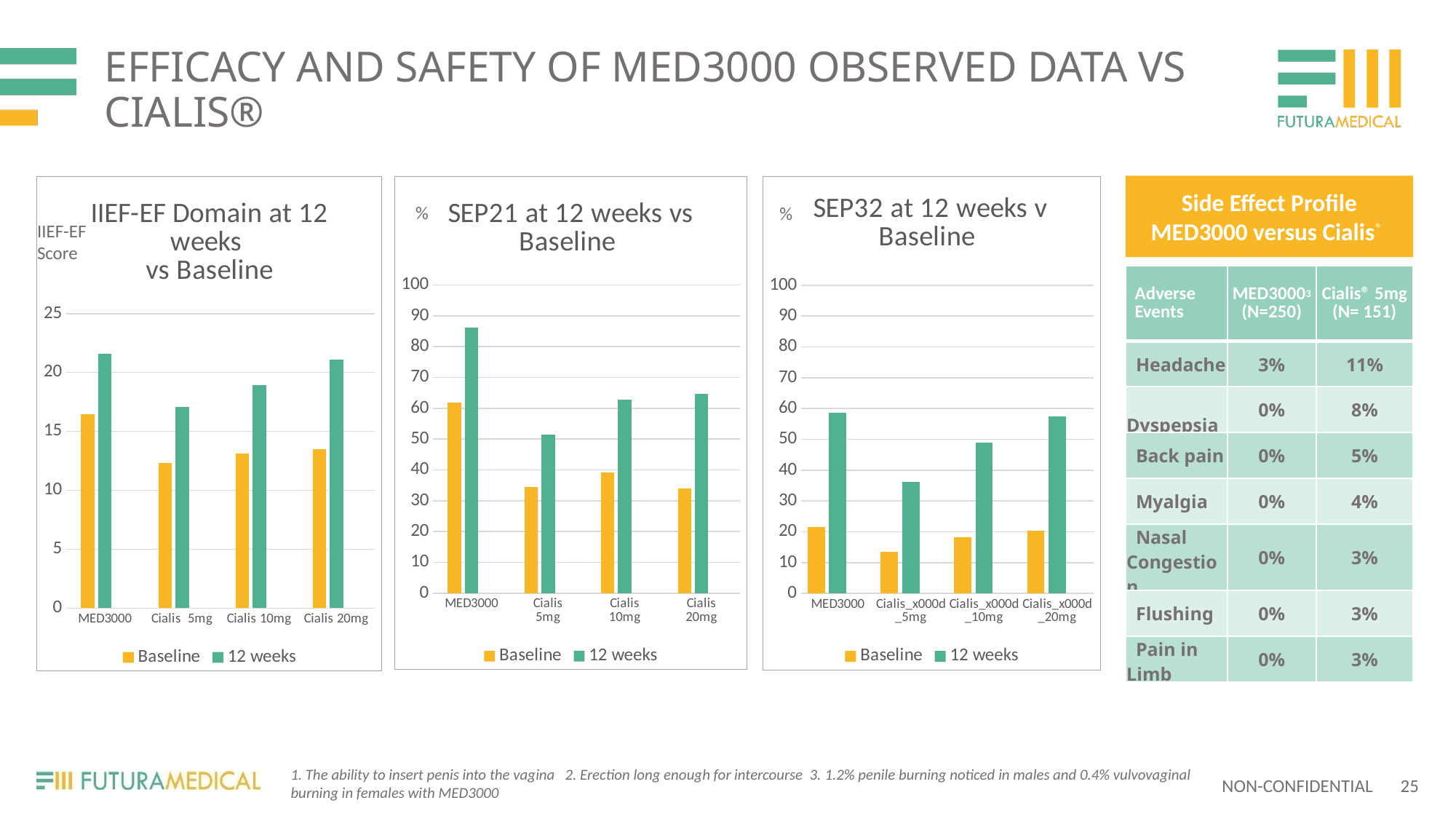
In the SEP32 at 12 weeks v Baseline chart, which category has the lowest Baseline value? Cialis 5mg In the SEP21 at 12 weeks vs Baseline chart, which category has the highest 12 weeks value? MED3000 In the SEP32 at 12 weeks v Baseline chart, is the 12 weeks value for Cialis 5mg greater or less than 40? less In the SEP21 at 12 weeks vs Baseline chart, is the 12 weeks value for MED3000 larger than the 12 weeks value for Cialis 10mg? Yes What kind of chart is the SEP32 at 12 weeks v Baseline chart? Bar chart In the SEP21 at 12 weeks vs Baseline chart, is the 12 weeks value for MED3000 greater or less than 80? greater In the IIEF-EF Domain at 12 weeks vs Baseline chart, is the 12 weeks value for MED3000 greater or less than 20? greater In the SEP32 at 12 weeks v Baseline chart, which is larger for Cialis 10mg: the Baseline value or the 12 weeks value? 12 weeks How many series does the legend of the SEP21 at 12 weeks vs Baseline chart list? 2 How many categories are shown on the x axis of the IIEF-EF Domain at 12 weeks vs Baseline chart? 4 In the IIEF-EF Domain at 12 weeks vs Baseline chart, which category has the highest Baseline value? MED3000 In the SEP21 at 12 weeks vs Baseline chart, which category has the lowest 12 weeks value? Cialis 5mg